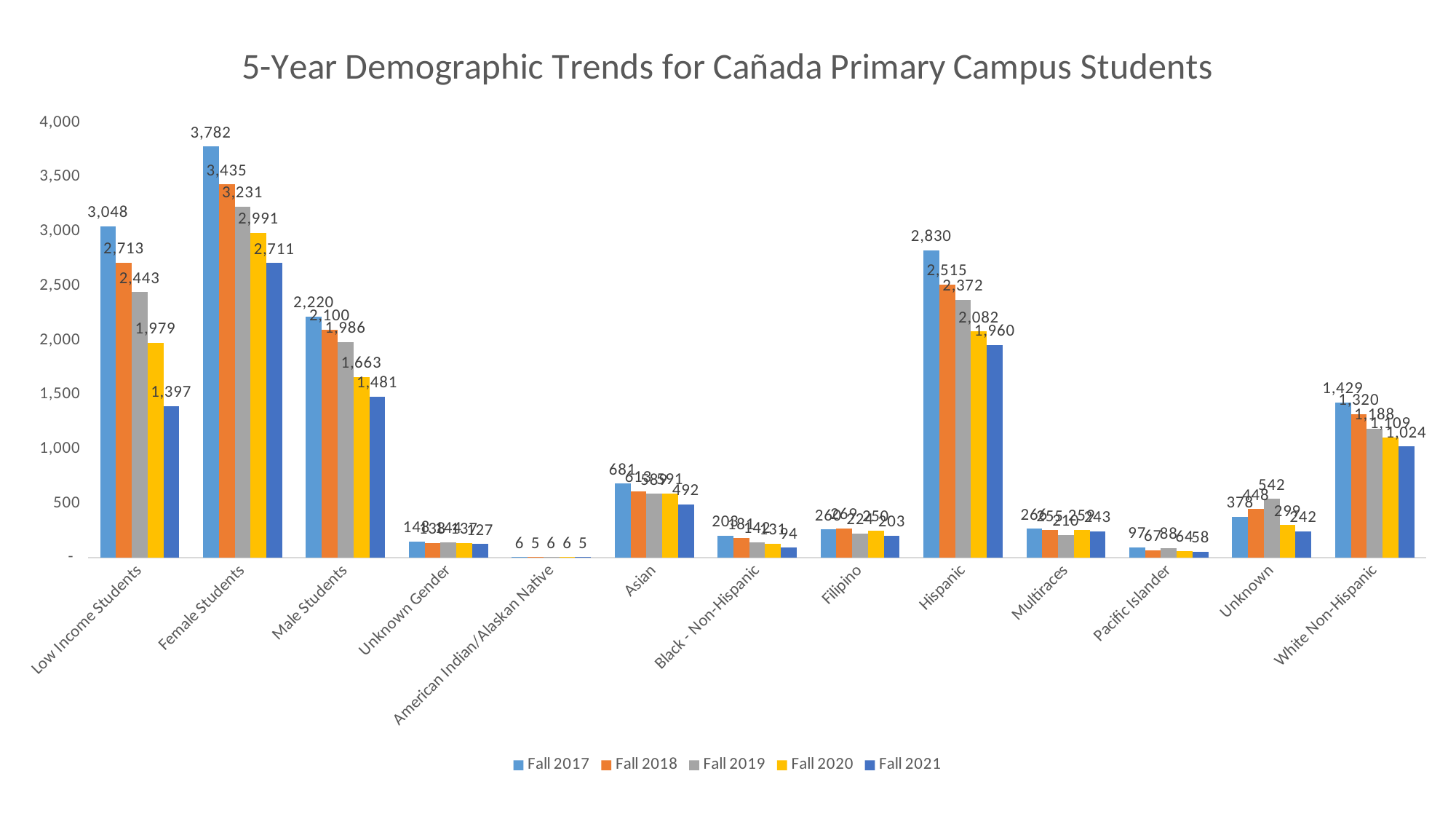
Is the value for Male Students in Fall 2021 greater or less than 1,500? less In Fall 2017, which is larger: Low Income Students or Hispanic students? Low Income Students How many series does the legend list? 5 What is the value for Hispanic students in Fall 2021? 1,960 What is the difference between Low Income Students in Fall 2017 and Fall 2021? 1,651 Do the values for Female Students rise or fall from Fall 2017 to Fall 2021? Fall What is the value for Female Students in Fall 2017? 3,782 What is the value for Low Income Students in Fall 2020? 1,979 How many categories are shown on the x axis? 13 In which term was the Unknown category highest? Fall 2019 What kind of chart is shown on the slide? Bar chart What is the value for White Non-Hispanic students in Fall 2021? 1,024